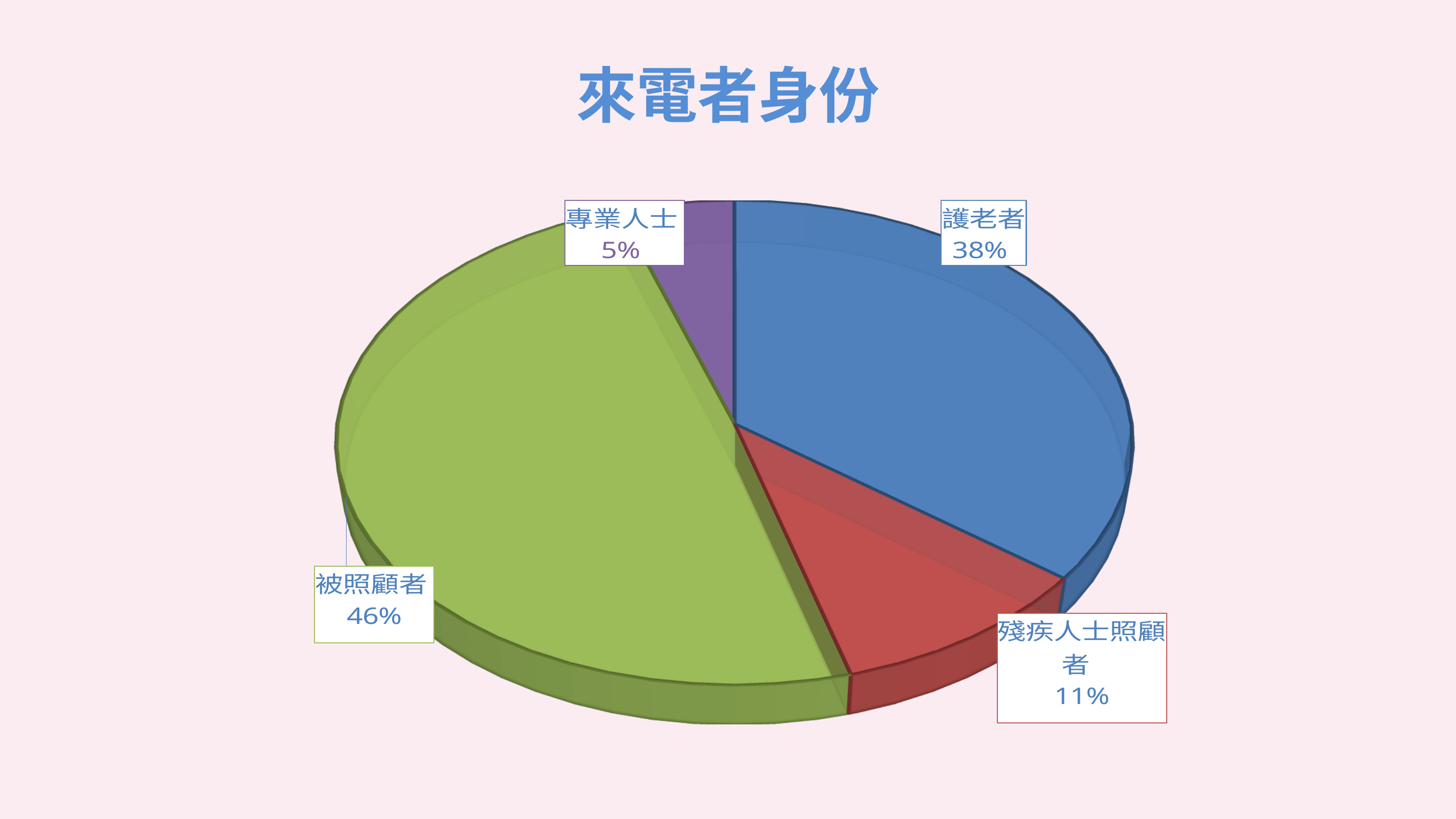
Which category has the largest share of the pie? 被照顧者 What colour is the slice for 被照顧者? green What is the title of the chart? 來電者身份 What kind of chart is shown on the slide? pie chart What share of the pie does 殘疾人士照顧者 have? 11% What is the difference in percentage points between 被照顧者 and 護老者? 8 What share of the pie does 專業人士 have? 5% What share of the pie does 被照顧者 have? 46% How many categories are shown in the pie chart? 4 Which is larger, the share for 護老者 or the share for 殘疾人士照顧者? 護老者 Which category has the smallest share of the pie? 專業人士